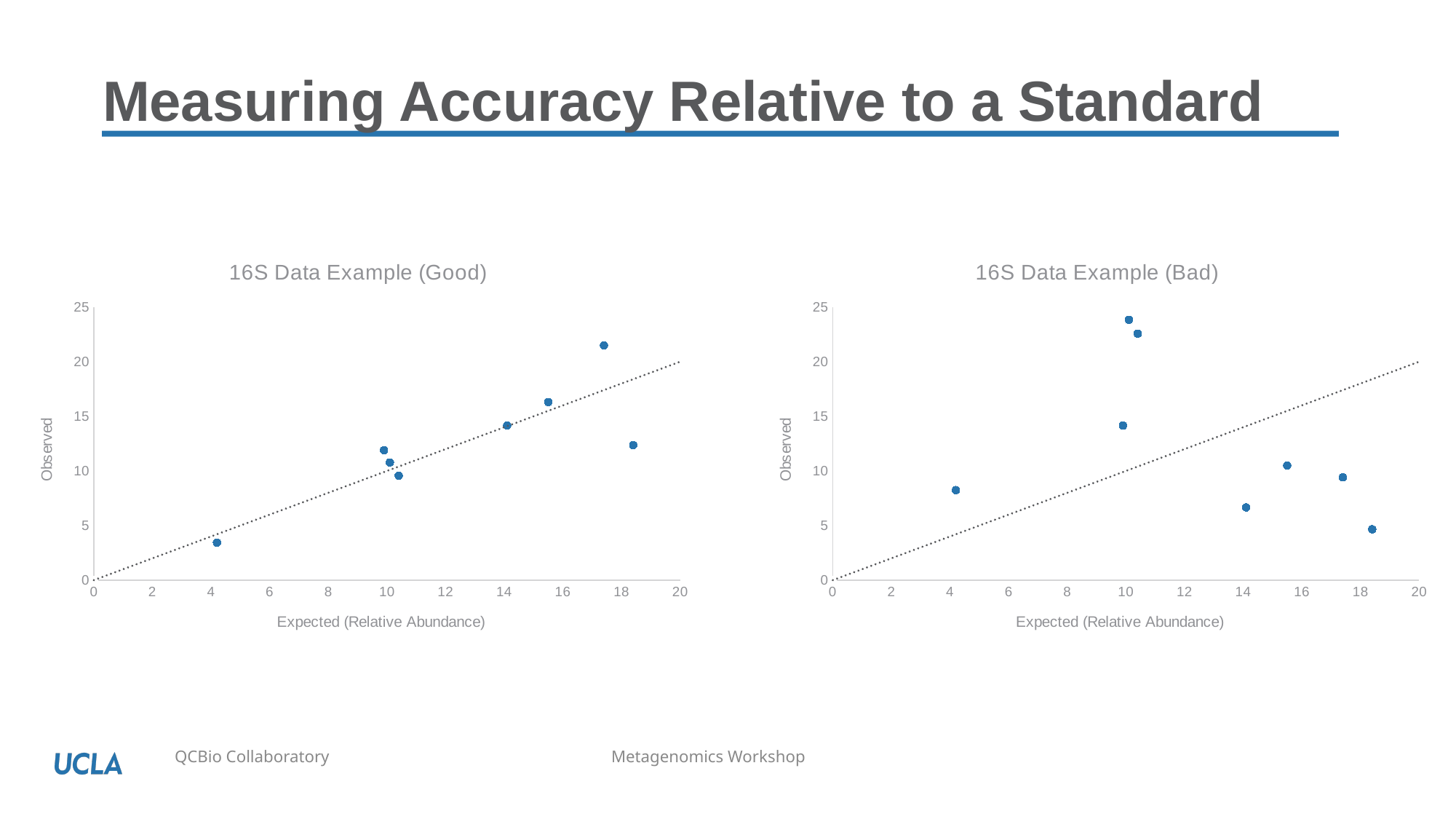
What kind of chart is the "16S Data Example (Good)" chart? Scatter chart What is the label of the x axis on the "16S Data Example (Bad)" chart? Expected (Relative Abundance) In the "16S Data Example (Bad)" chart, are the two highest points above or below the dotted reference line? Above In the "16S Data Example (Bad)" chart, which has the larger observed value: the point at expected about 10 near the top, or the point at expected about 14? The point at expected about 10 What is the label of the y axis on the "16S Data Example (Good)" chart? Observed In the "16S Data Example (Good)" chart, is the observed value of the point at expected abundance of about 4 greater or less than 5? less In the "16S Data Example (Bad)" chart, is the observed value of the point at expected abundance of about 4 greater or less than 5? greater How many data points are plotted in the "16S Data Example (Bad)" chart? 8 In the "16S Data Example (Good)" chart, do the observed values generally rise or fall as expected abundance increases? Rise In the "16S Data Example (Good)" chart, is the observed value of the highest point greater or less than 20? greater How many data points are plotted in the "16S Data Example (Good)" chart? 8